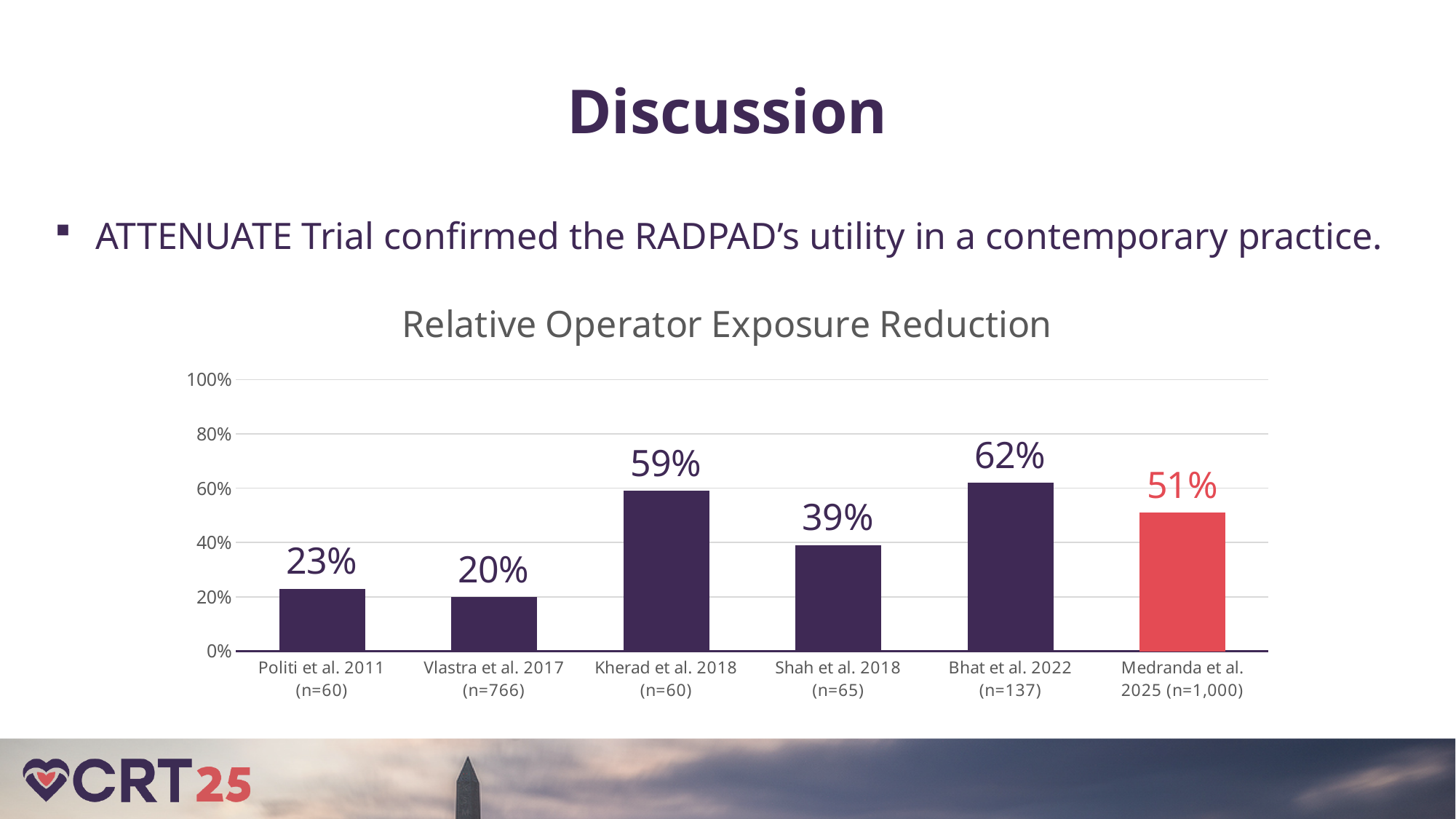
How many studies are shown on the chart? 6 What is the relative operator exposure reduction for Medranda et al. 2025 (n=1,000)? 51% What is the value shown for Vlastra et al. 2017 (n=766)? 20% Is the value for Medranda et al. 2025 greater or less than 40%? greater Which study shows the lowest relative operator exposure reduction? Vlastra et al. 2017 (n=766) What is the difference between the values for Bhat et al. 2022 and Shah et al. 2018? 23% Which has a larger relative operator exposure reduction, Politi et al. 2011 or Shah et al. 2018? Shah et al. 2018 What is the relative operator exposure reduction for Kherad et al. 2018 (n=60)? 59% Which study shows the highest relative operator exposure reduction? Bhat et al. 2022 (n=137) What kind of chart is shown on the slide? Bar chart Which study's bar is coloured red instead of dark purple? Medranda et al. 2025 (n=1,000) What is the title of the chart? Relative Operator Exposure Reduction